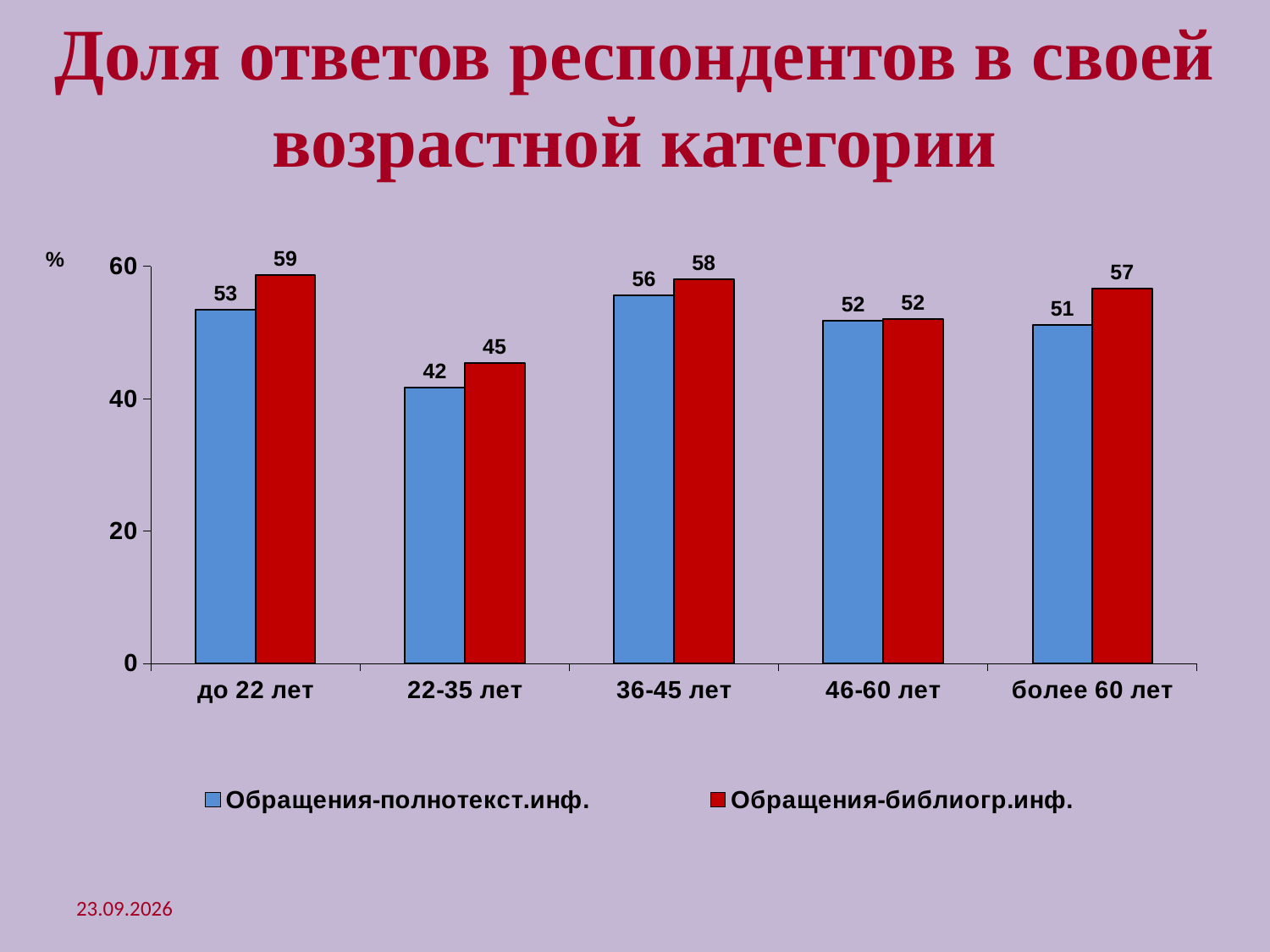
How many age categories are shown on the x axis? 5 What is the value for 'Обращения-полнотекст.инф.' in the '36-45 лет' category? 56 Is the value for 'Обращения-полнотекст.инф.' in the '22-35 лет' category greater or less than 40? greater In the '22-35 лет' category, which series has the larger value: 'Обращения-полнотекст.инф.' or 'Обращения-библиогр.инф.'? Обращения-библиогр.инф. What kind of chart is shown on the slide? bar chart Which age category has the highest value for 'Обращения-библиогр.инф.'? до 22 лет What is the value for 'Обращения-полнотекст.инф.' in the 'до 22 лет' category? 53 Which age category has the lowest value for 'Обращения-полнотекст.инф.'? 22-35 лет What is the value for 'Обращения-библиогр.инф.' in the '22-35 лет' category? 45 What colour are the bars for 'Обращения-библиогр.инф.'? red What is the difference between 'Обращения-библиогр.инф.' and 'Обращения-полнотекст.инф.' in the 'более 60 лет' category? 6 How many series does the legend list? 2